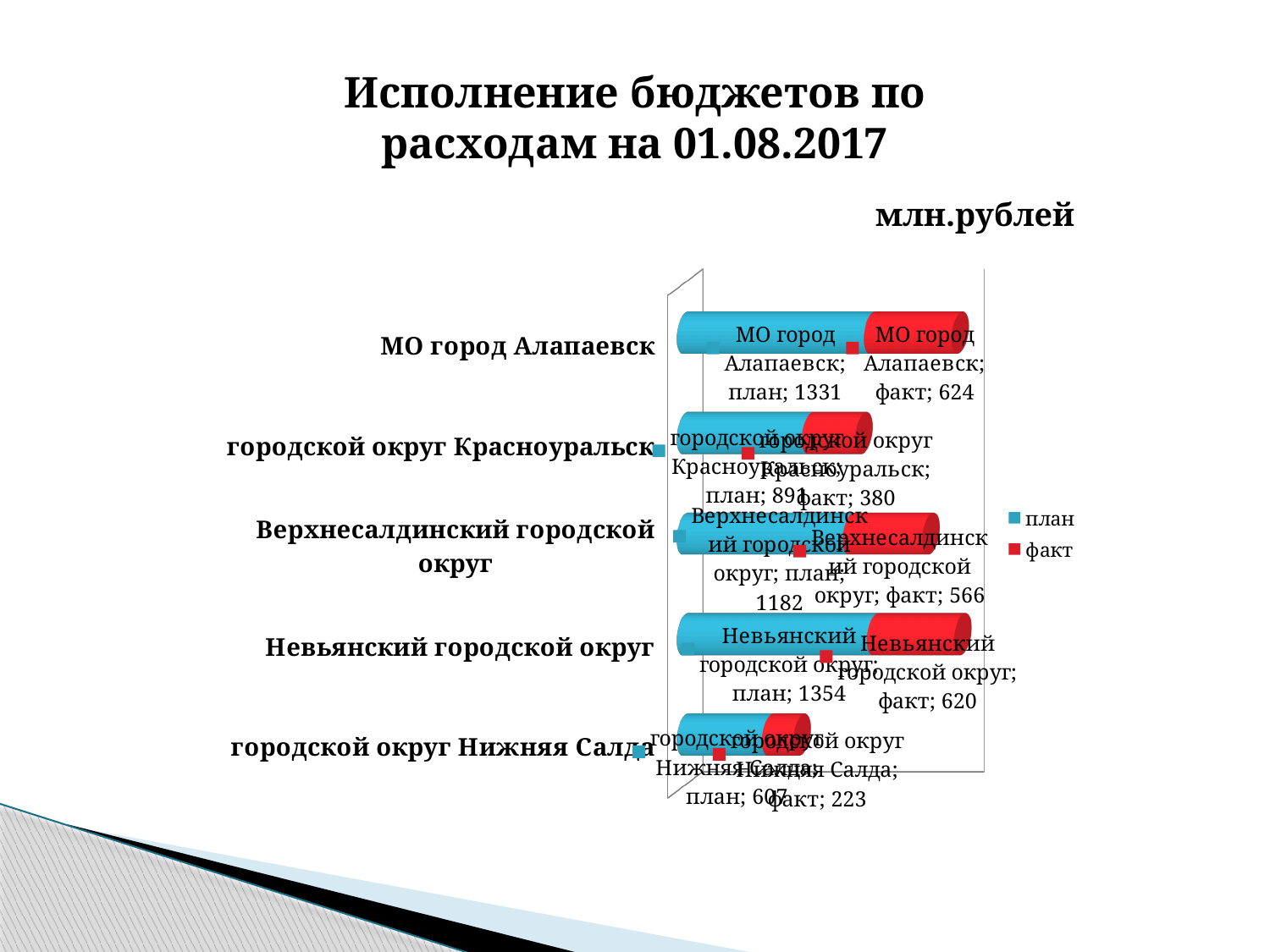
Which is larger: the факт value for МО город Алапаевск or the факт value for городской округ Красноуральск? МО город Алапаевск What is the факт value for Верхнесалдинский городской округ? 566 How many categories are shown in the chart? 5 Which category has the lowest факт value? городской округ Нижняя Салда What is the план value for городской округ Красноуральск? 891 How many series does the legend list? 2 What is the факт value for городской округ Нижняя Салда? 223 Which category has the highest план value? Невьянский городской округ What is the difference between план and факт for Невьянский городской округ? 734 What type of chart is shown on the slide? bar chart What is the факт value for МО город Алапаевск? 624 What is the план value for МО город Алапаевск? 1331